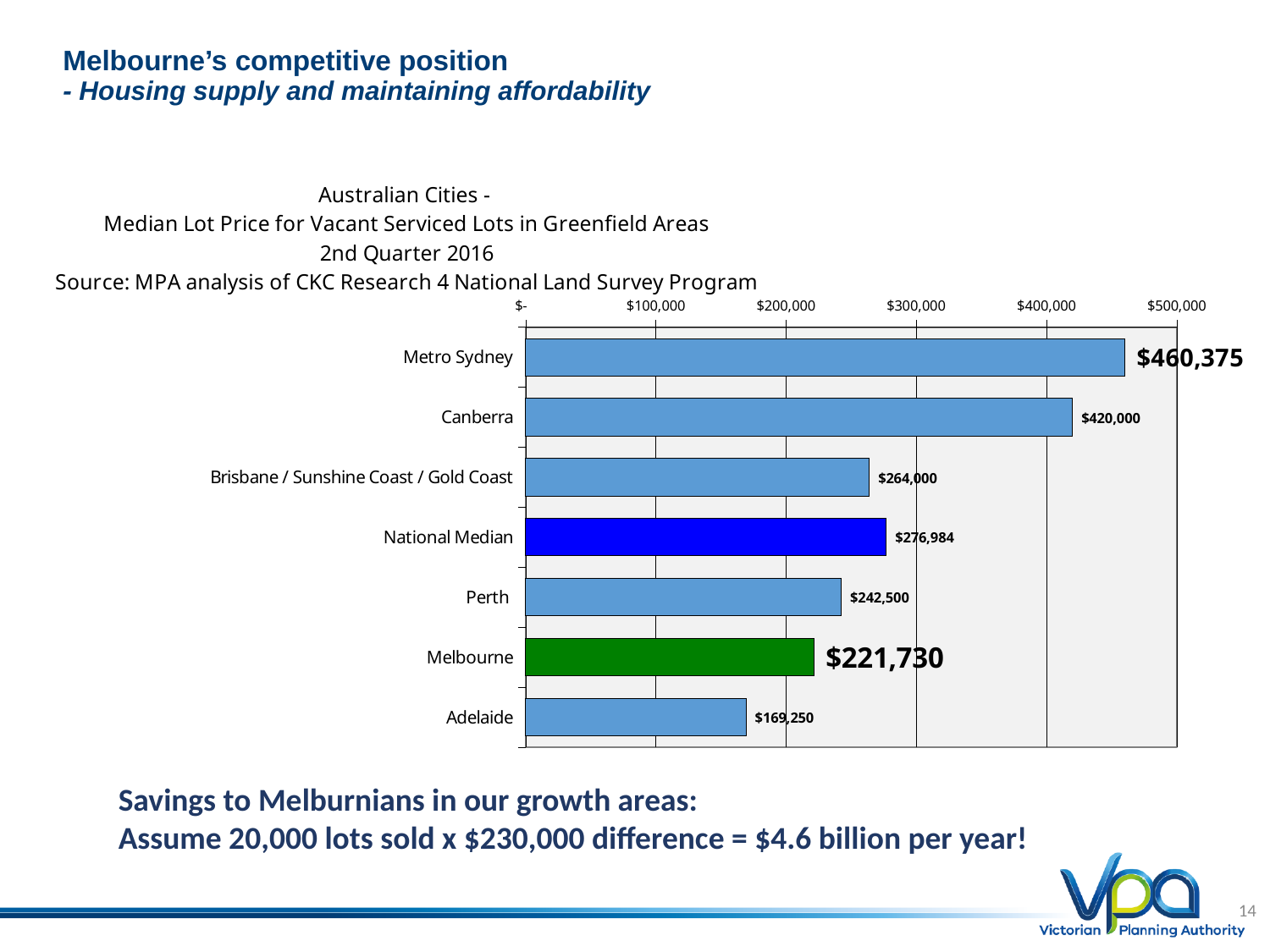
Which has a higher median lot price, Perth or Brisbane / Sunshine Coast / Gold Coast? Brisbane / Sunshine Coast / Gold Coast What colour is the Melbourne bar in the chart? Green What is the median lot price shown for Melbourne? $221,730 What is the median lot price shown for Adelaide? $169,250 What is the difference between the Metro Sydney and Melbourne median lot prices? $238,645 Which city has the lowest median lot price in the chart? Adelaide What type of chart is shown on the slide? Bar chart What value is shown for the National Median? $276,984 What is the difference between the National Median and the Melbourne value? $55,254 What is the median lot price shown for Metro Sydney? $460,375 How many bars are plotted in the chart? 7 Which city has the highest median lot price in the chart? Metro Sydney